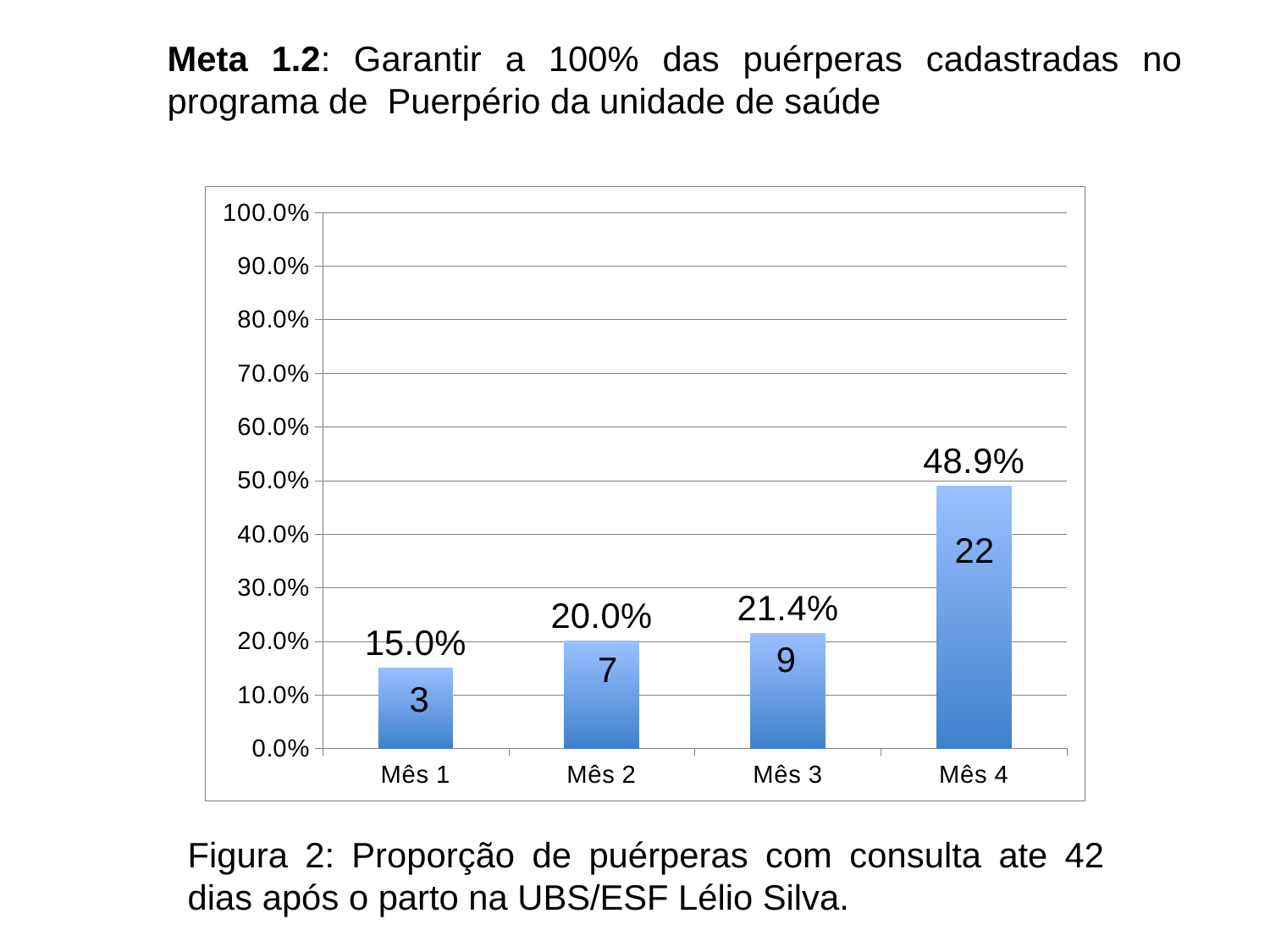
What is the difference between the values for Mês 4 and Mês 1? 33.9% Do the values rise or fall from Mês 1 to Mês 4? rise How many months are shown on the x axis? 4 What is the value for Mês 3? 21.4% Is the value for Mês 4 greater or less than 40.0%? greater What kind of chart is shown? bar chart What count is printed inside the bar for Mês 2? 7 Which month has the lowest value? Mês 1 What is the value for Mês 4? 48.9% Which month has the highest value? Mês 4 Which is larger, the value for Mês 2 or the value for Mês 3? Mês 3 What is the value for Mês 1? 15.0%